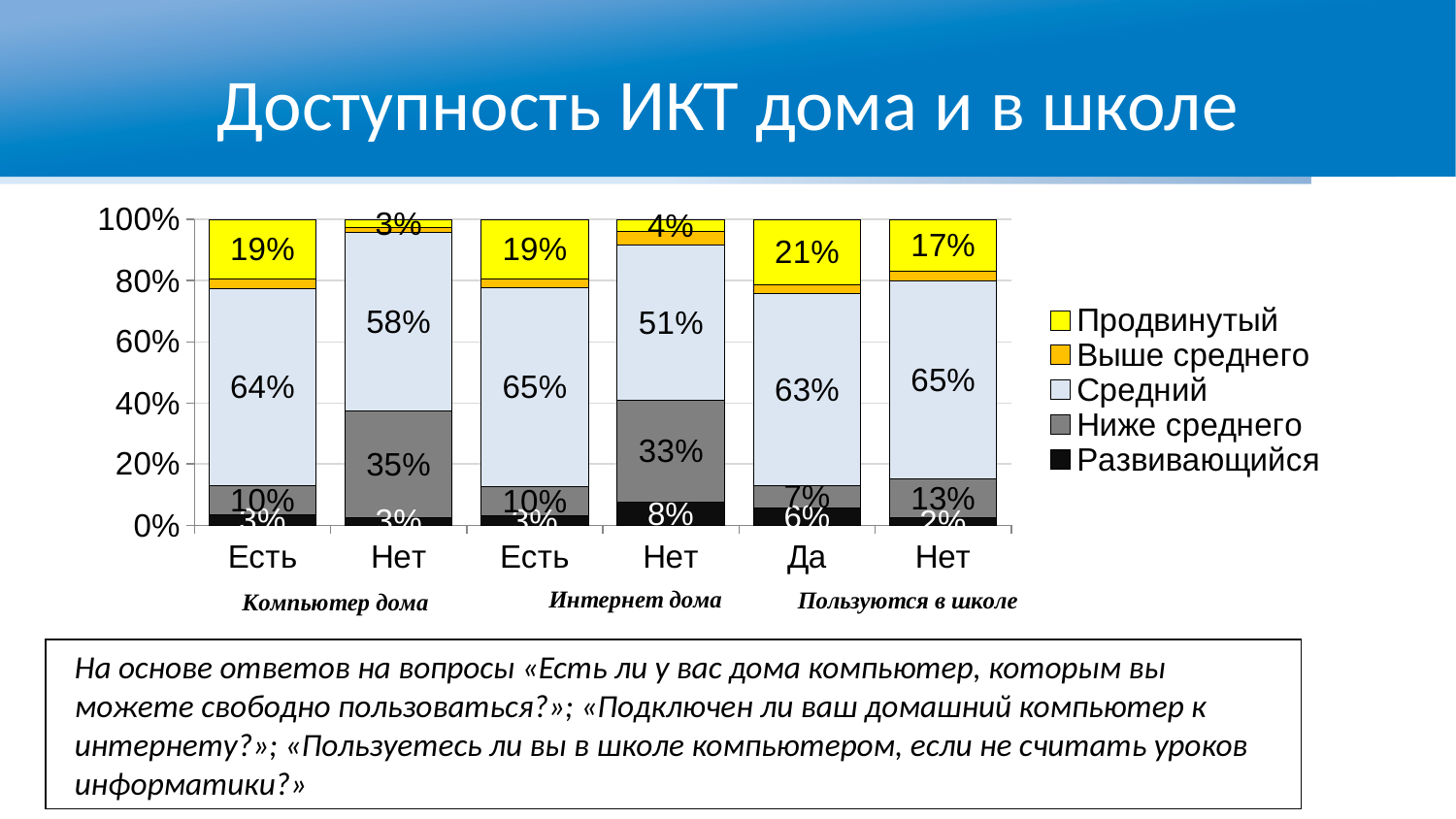
What is the value of the 'Средний' segment for the 'Нет' bar under 'Интернет дома'? 51% What is the value of the 'Ниже среднего' segment for the 'Нет' bar under 'Пользуются в школе'? 13% What is the difference between the 'Ниже среднего' values of the 'Нет' and 'Есть' bars under 'Интернет дома'? 23% Which is larger: the 'Продвинутый' value for 'Есть' under 'Компьютер дома' or for 'Нет' under 'Компьютер дома'? Есть Which bar has the lowest 'Средний' value? Нет (Интернет дома) How many bars are plotted in the chart? 6 What is the value of the 'Продвинутый' segment for the 'Да' bar under 'Пользуются в школе'? 21% What is the value of the 'Средний' segment for the 'Есть' bar under 'Компьютер дома'? 64% What is the value of the 'Ниже среднего' segment for the 'Нет' bar under 'Компьютер дома'? 35% What kind of chart is shown on the slide? stacked bar chart How many series does the legend list? 5 Which bar has the highest 'Продвинутый' value? Да (Пользуются в школе)